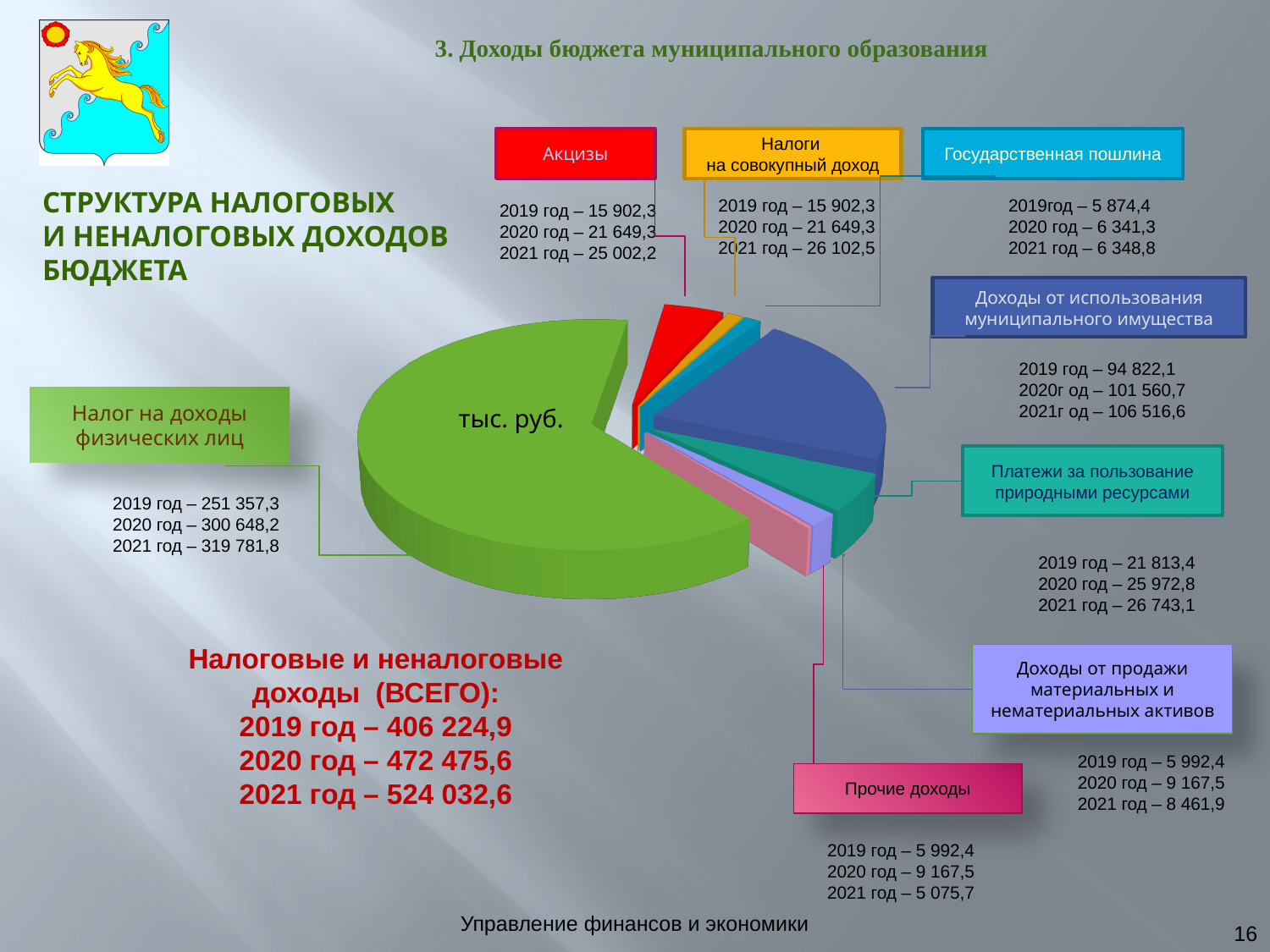
What is the value of Налог на доходы физических лиц for 2021? 319 781,8 What is the value of Государственная пошлина for 2020? 6 341,3 Which category is the largest slice of the pie chart? Налог на доходы физических лиц What is the value of Прочие доходы for 2021? 5 075,7 What is the value of Доходы от использования муниципального имущества for 2019? 94 822,1 How many slices does the pie chart have? 8 By how much did Налог на доходы физических лиц increase from 2019 to 2021? 68 424,5 What kind of chart is shown on the slide? pie chart What is the total of Налоговые и неналоговые доходы (ВСЕГО) for 2020? 472 475,6 Which is larger in 2021: Платежи за пользование природными ресурсами or Акцизы? Платежи за пользование природными ресурсами Do the values of Налог на доходы физических лиц rise or fall from 2019 to 2021? rise What unit is printed on the pie chart? тыс. руб.